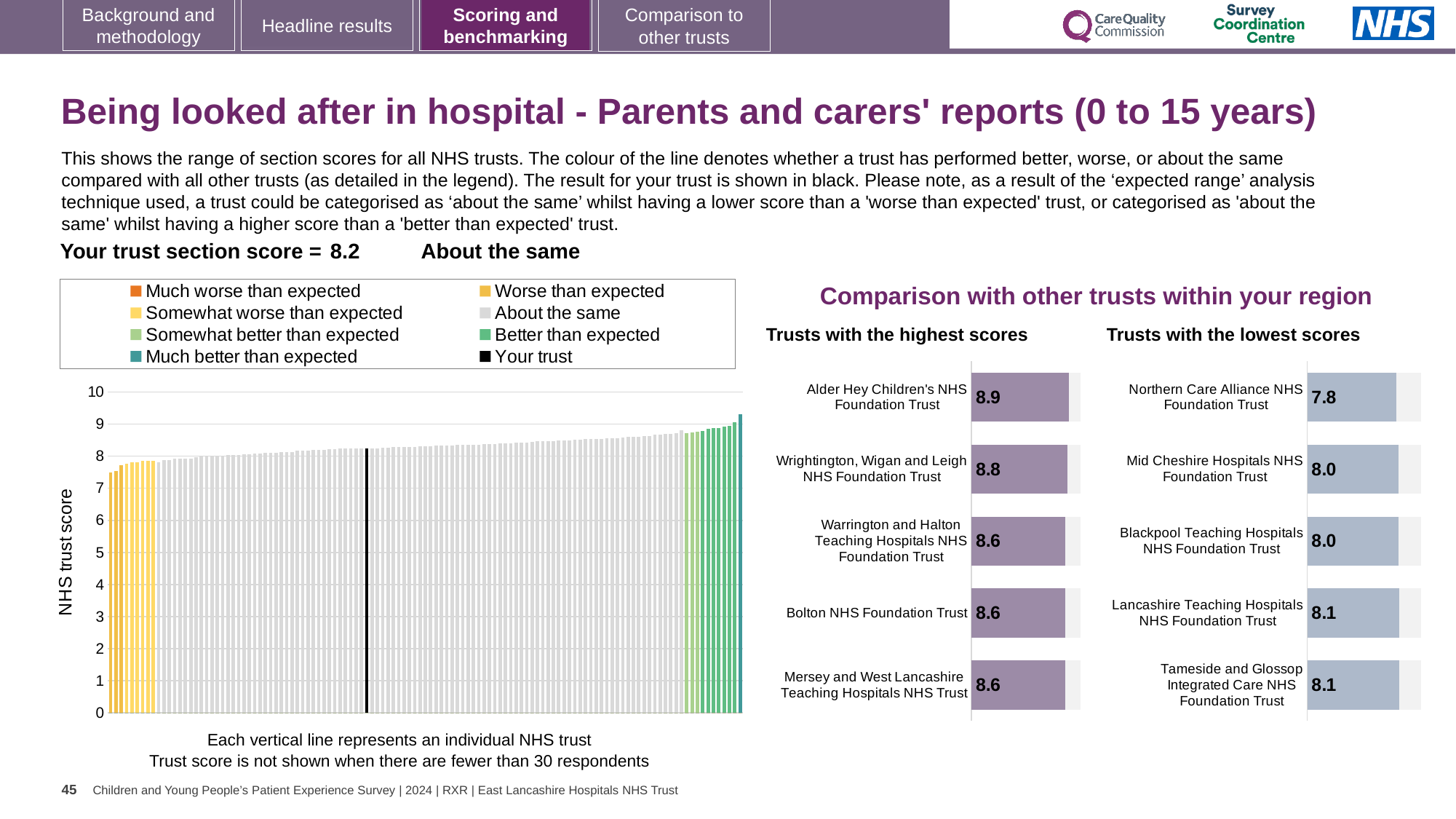
In the 'Trusts with the highest scores' chart, what is the difference between the scores of Alder Hey Children's NHS Foundation Trust and Bolton NHS Foundation Trust? 0.3 In the large 'NHS trust score' chart on the left, do the bar values rise or fall from left to right? rise In the 'Trusts with the lowest scores' chart, what is the score for Northern Care Alliance NHS Foundation Trust? 7.8 How many entries does the legend above the large 'NHS trust score' chart list? 8 In the 'Trusts with the highest scores' chart, which trust has the highest score? Alder Hey Children's NHS Foundation Trust How many trusts are listed in the 'Trusts with the highest scores' chart? 5 In the 'Trusts with the lowest scores' chart, what is the difference between the scores of Tameside and Glossop Integrated Care NHS Foundation Trust and Northern Care Alliance NHS Foundation Trust? 0.3 In the 'Trusts with the lowest scores' chart, which trust has the lowest score? Northern Care Alliance NHS Foundation Trust In the large 'NHS trust score' chart on the left, are the values for the leftmost yellow bars greater or less than 8? less In the 'Trusts with the lowest scores' chart, which has the higher score: Lancashire Teaching Hospitals NHS Foundation Trust or Mid Cheshire Hospitals NHS Foundation Trust? Lancashire Teaching Hospitals NHS Foundation Trust In the 'Trusts with the highest scores' chart, what is the score for Alder Hey Children's NHS Foundation Trust? 8.9 What is the section score for your trust shown on the slide? 8.2